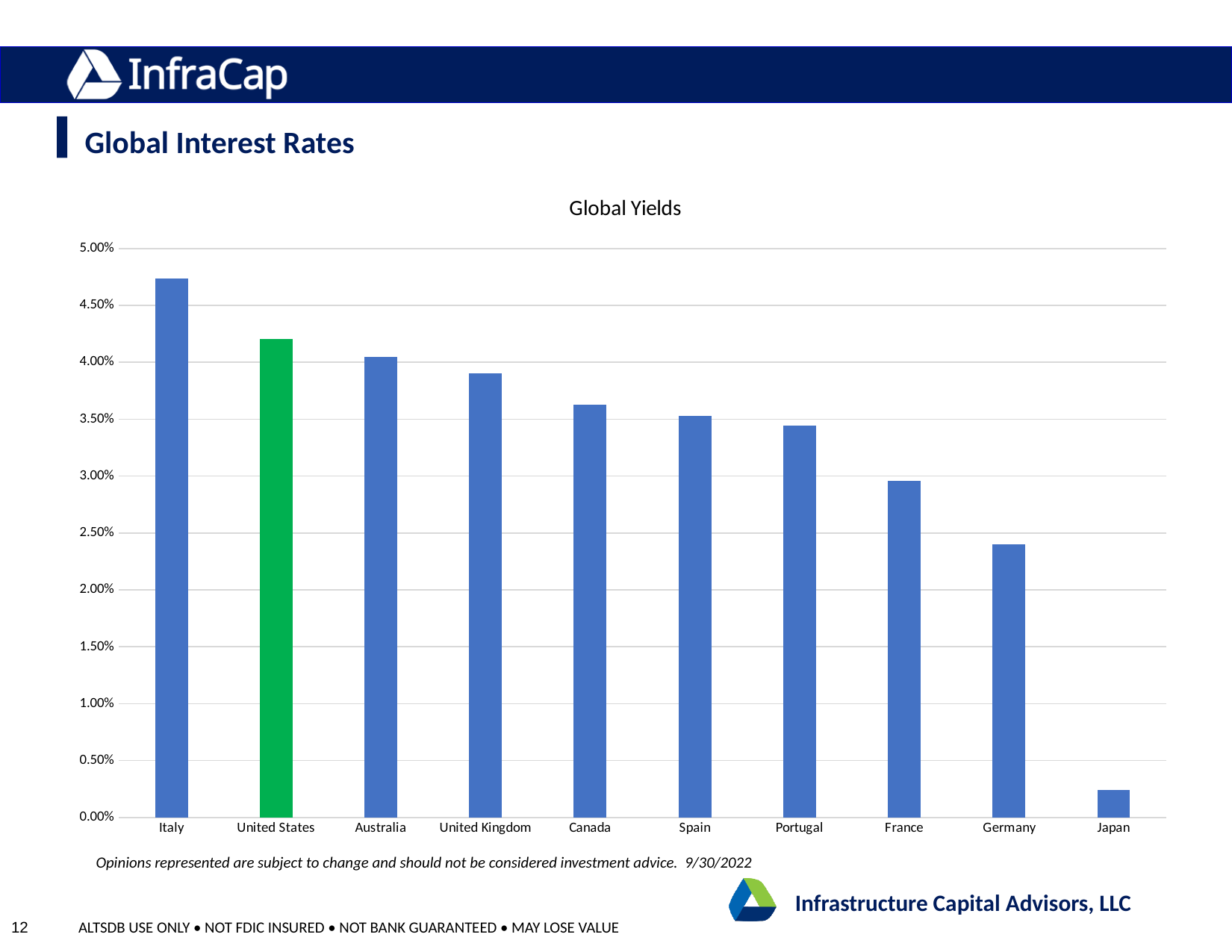
How many countries are shown on the chart? 10 Is the value for Japan greater or less than 0.50%? less Which country's bar is coloured green rather than blue? United States Is the value for United States greater or less than 4.00%? greater Which has a higher yield, Australia or Germany? Australia Is the value for Germany greater or less than 2.50%? less What kind of chart is shown on the slide? bar chart Which country has the lowest yield? Japan What is the title of the chart? Global Yields Do the yields rise or fall moving from left to right across the chart? fall Which country has the highest yield? Italy